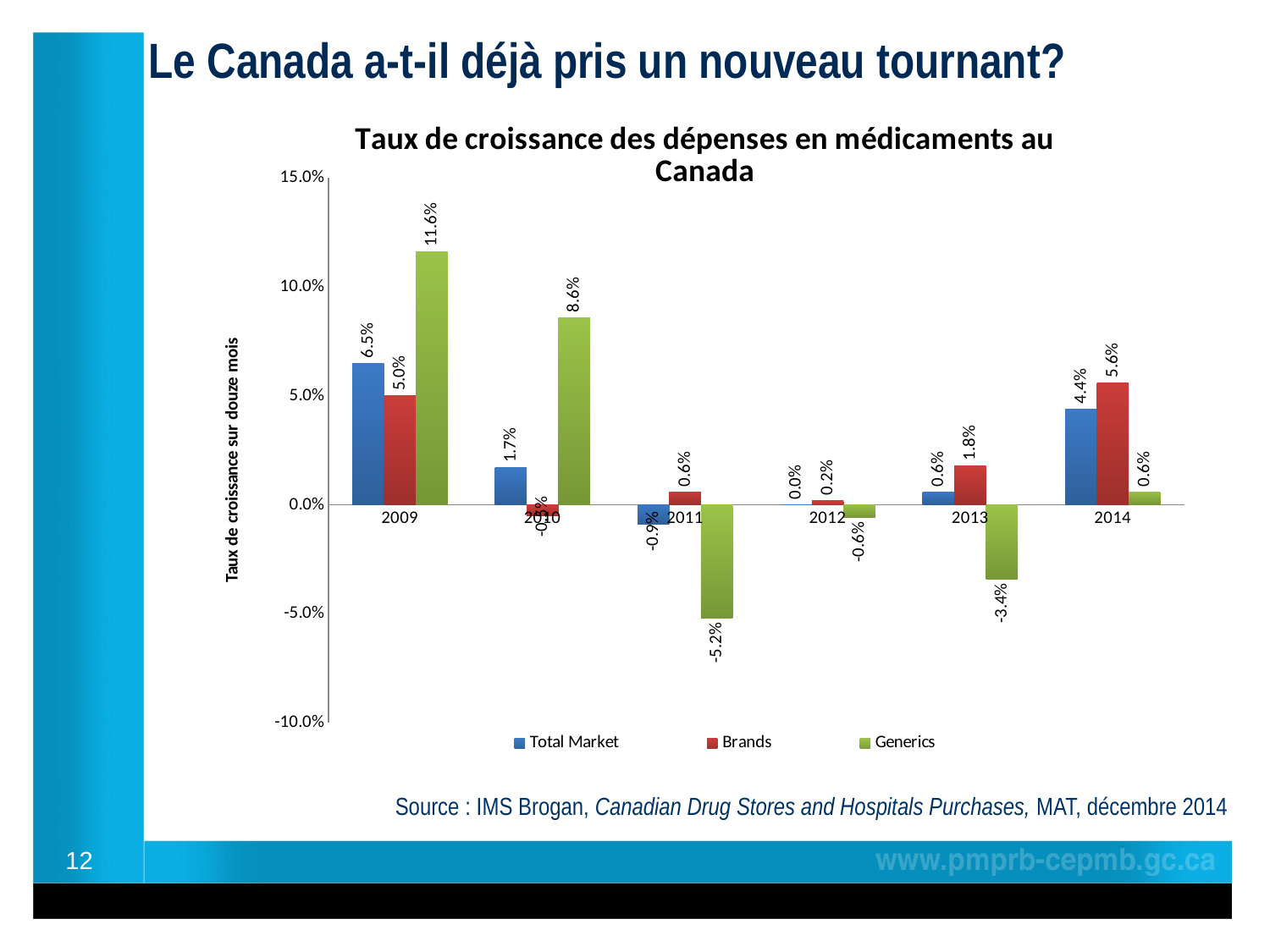
What is the title of the chart? Taux de croissance des dépenses en médicaments au Canada What is the Generics value for 2011? -5.2% In which year is the Generics growth rate highest? 2009 What is the difference between the Generics and Total Market values in 2009? 5.1% What kind of chart is shown on the slide? Bar chart In 2014, which is larger: the Brands value or the Total Market value? Brands What is the Brands value for 2013? 1.8% How many series does the legend list? 3 What is the Generics growth rate for 2009? 11.6% How many years are shown on the x axis? 6 What is the Total Market growth rate for 2014? 4.4% In which year is the Generics growth rate lowest? 2011